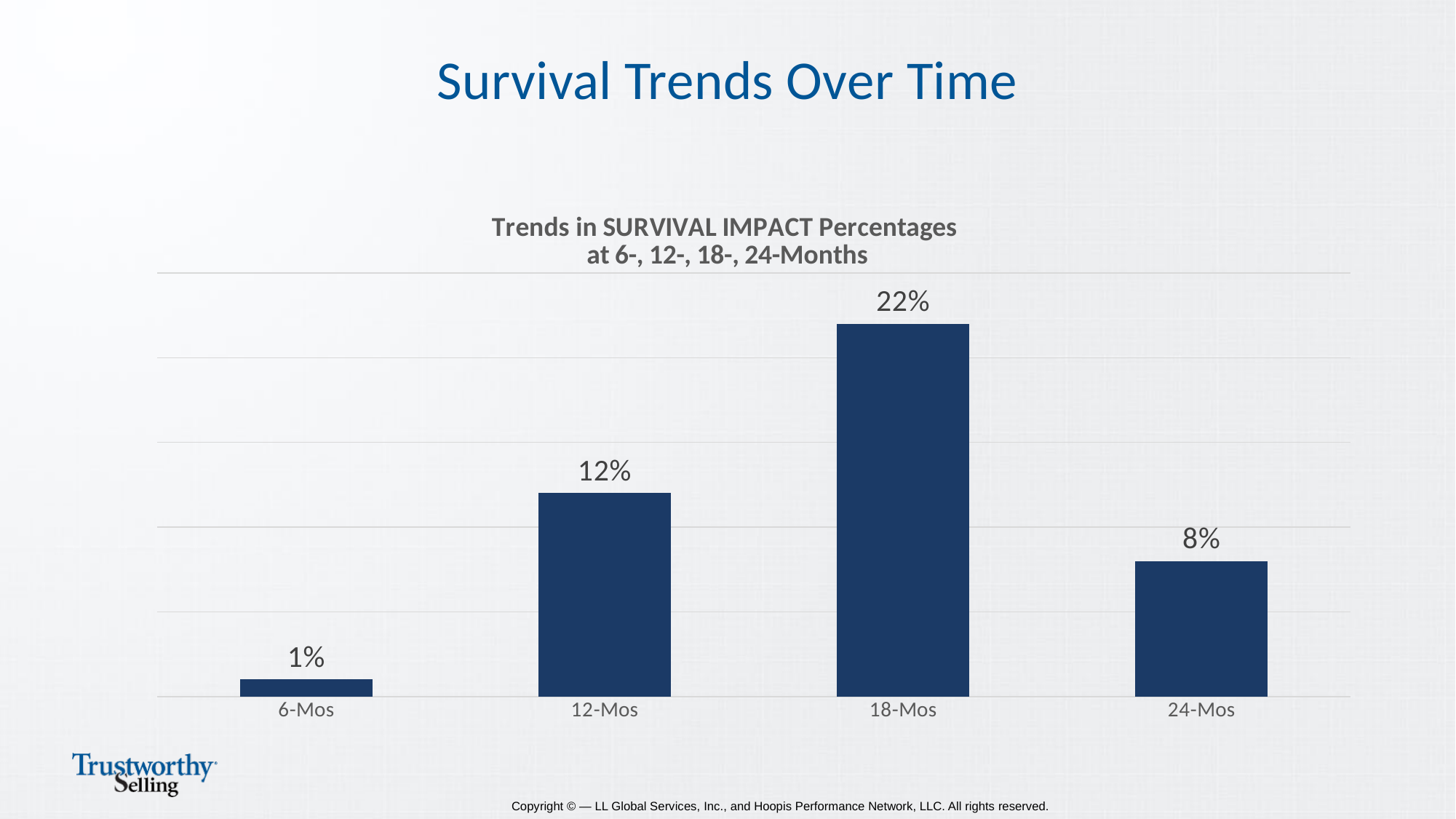
What is the survival impact percentage at 18-Mos? 22% What type of chart is shown on the slide? Bar chart Which time point has the lowest survival impact percentage? 6-Mos How many time points are shown in the chart? 4 What is the title of the chart? Trends in SURVIVAL IMPACT Percentages at 6-, 12-, 18-, 24-Months What is the survival impact percentage at 12-Mos? 12% What is the survival impact percentage at 24-Mos? 8% What is the difference between the survival impact percentages at 24-Mos and 6-Mos? 7% What is the survival impact percentage at 6-Mos? 1% Which time point has the highest survival impact percentage? 18-Mos What is the difference between the survival impact percentages at 18-Mos and 12-Mos? 10% Which has a larger survival impact percentage, 12-Mos or 24-Mos? 12-Mos